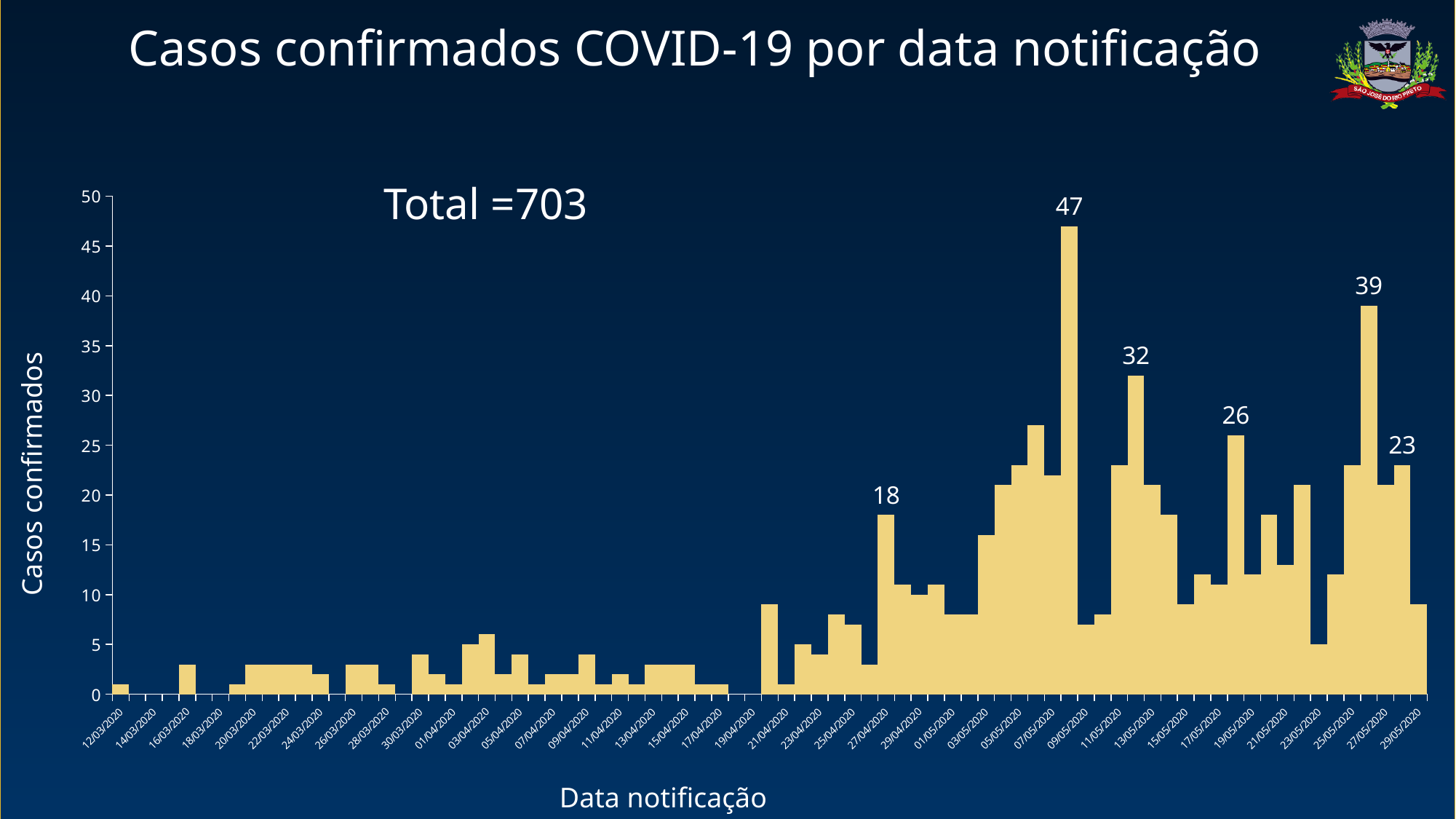
What is the title of the chart? Casos confirmados COVID-19 por data notificação What is the difference between the bars labeled 32 and 26? 6 What kind of chart is shown on the slide? bar chart Overall, do the daily case counts rise or fall from March to May along the x axis? rise Is the value for 12/03/2020 greater or less than 5? less How many bars have a printed data label? 6 Which is larger, the bar labeled 32 or the bar labeled 23? 32 What is the label of the vertical axis? Casos confirmados What is the highest value labeled on any bar in the chart? 47 What is the difference between the two highest labeled bars (47 and 39)? 8 What total is printed on the chart? 703 What is the lowest value among the data labels printed on the chart? 18